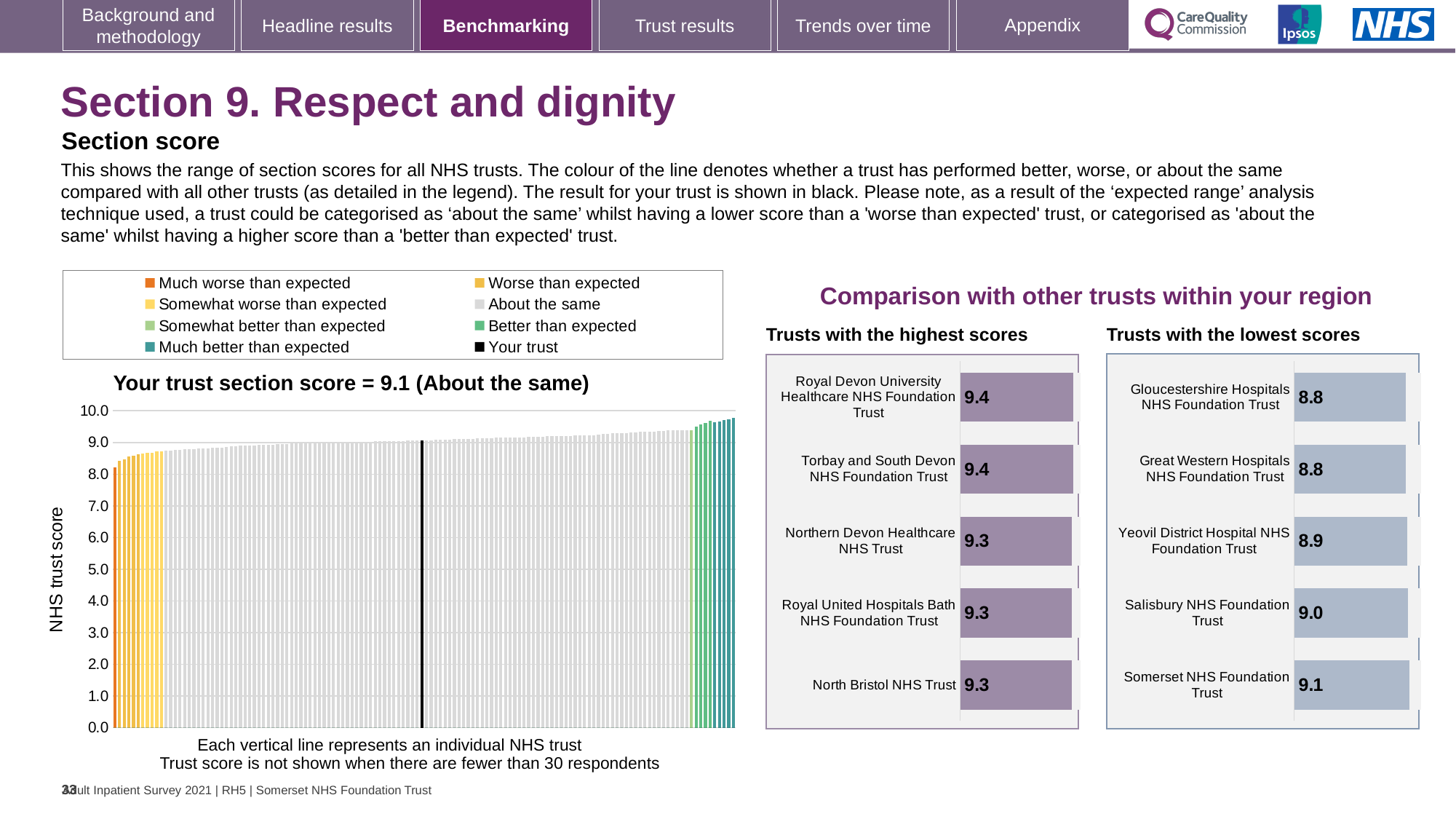
In the 'Your trust section score' chart, is the value of the leftmost (lowest) bar greater or less than 8.0? greater What kind of chart is the 'Your trust section score' chart? bar chart What is the y-axis label of the 'Your trust section score' chart? NHS trust score In the 'Your trust section score' chart, what is the section score for your trust? 9.1 In the 'Trusts with the highest scores' chart, what is the difference between the scores of Royal Devon University Healthcare NHS Foundation Trust and North Bristol NHS Trust? 0.1 In the 'Trusts with the lowest scores' chart, which has the larger score: Yeovil District Hospital NHS Foundation Trust or Salisbury NHS Foundation Trust? Salisbury NHS Foundation Trust How many entries does the legend above the 'Your trust section score' chart list? 8 In the 'Trusts with the lowest scores' chart, what is the difference between the scores of Somerset NHS Foundation Trust and Gloucestershire Hospitals NHS Foundation Trust? 0.3 In the 'Trusts with the lowest scores' chart, which trust has the highest score? Somerset NHS Foundation Trust In the 'Trusts with the highest scores' chart, what is the score for Northern Devon Healthcare NHS Trust? 9.3 In the 'Your trust section score' chart, do the bars rise or fall from left to right along the x axis? rise In the 'Trusts with the highest scores' chart, how many trusts are shown? 5